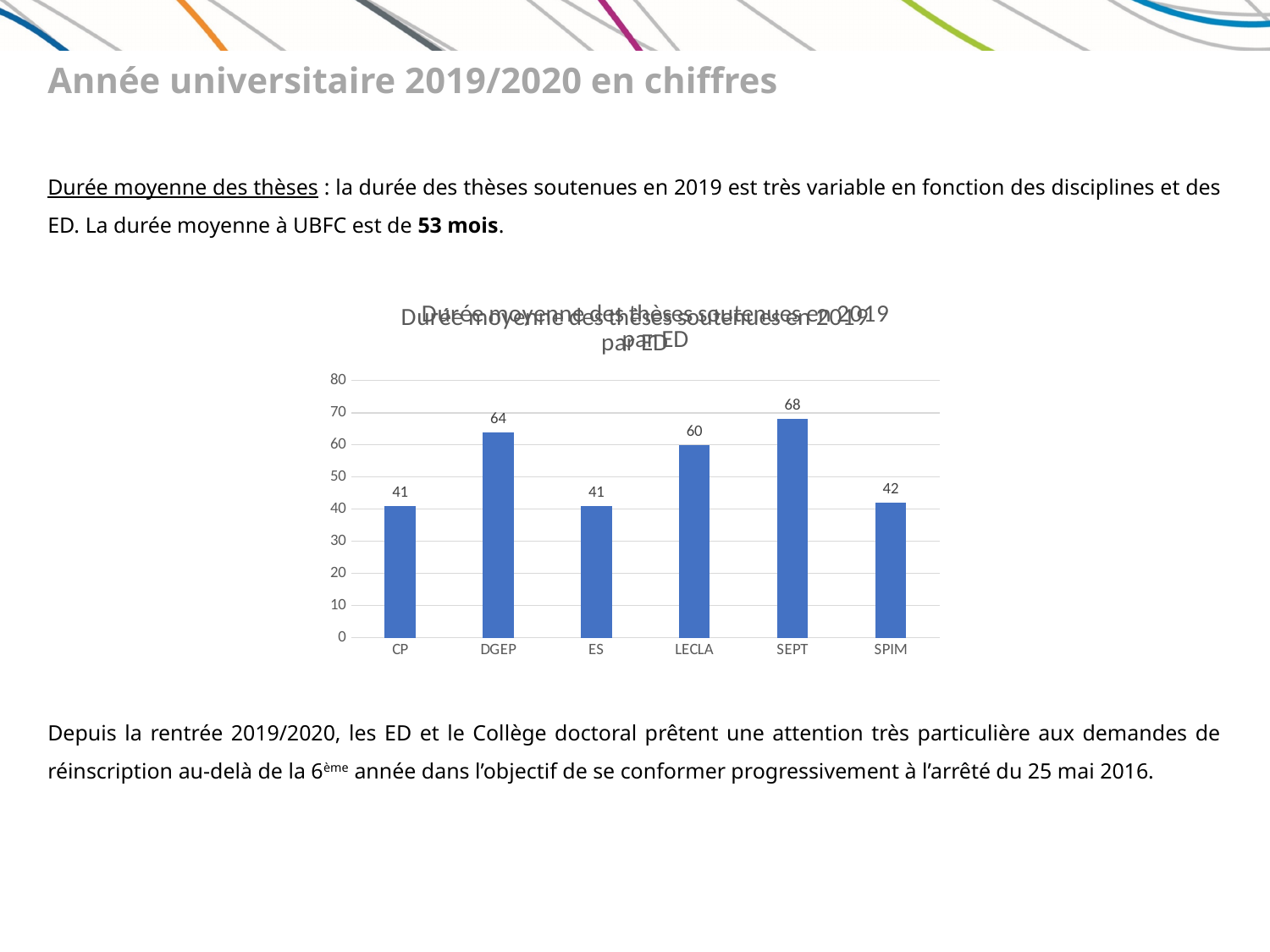
Which is larger, the value for DGEP or the value for SPIM? DGEP What is the value for SEPT? 68 How many categories are shown on the x axis? 6 What is the value for SPIM? 42 What is the value for LECLA? 60 What is the difference between the values for SEPT and CP? 27 Is the value for ES greater or less than 50? less What is the difference between the values for DGEP and LECLA? 4 What kind of chart is shown on the slide? bar chart What is the value for DGEP? 64 What is the value for CP? 41 Which category has the highest value? SEPT